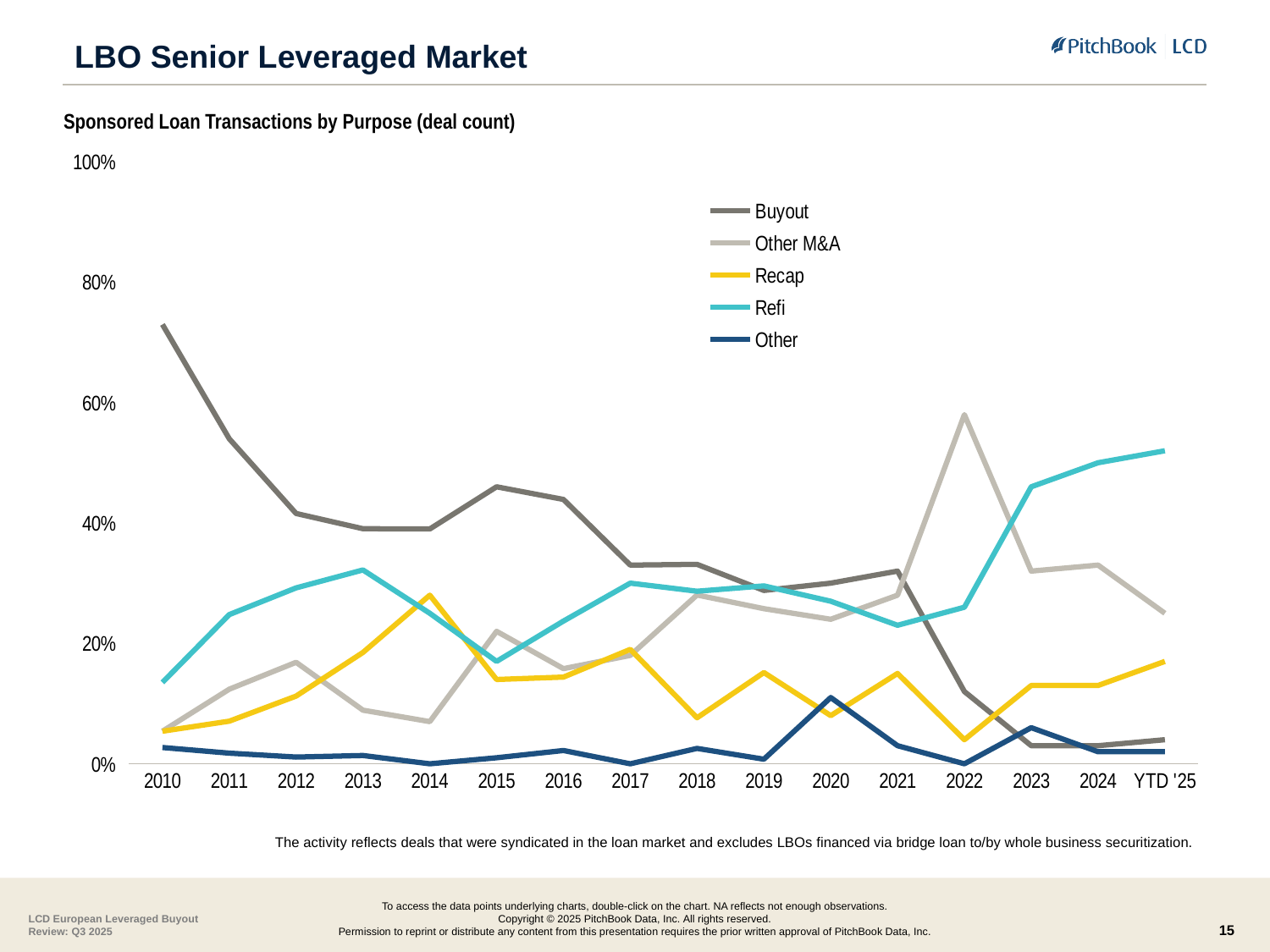
How many time periods are shown along the x axis? 16 What is the title of the chart? Sponsored Loan Transactions by Purpose (deal count) Which series is plotted with the yellow line? Recap Which series has the highest value in 2022? Other M&A Which is larger in 2010, the Buyout value or the Refi value? Buyout Is the value for Refi in YTD '25 greater or less than 40%? greater What kind of chart is shown on the slide? line chart Is the value for Buyout in 2022 greater or less than 20%? less Which series has the lowest value in 2010? Other In which year does the Buyout series reach its highest value? 2010 Is the value for Buyout in 2010 greater or less than 60%? greater How many series does the legend list? 5